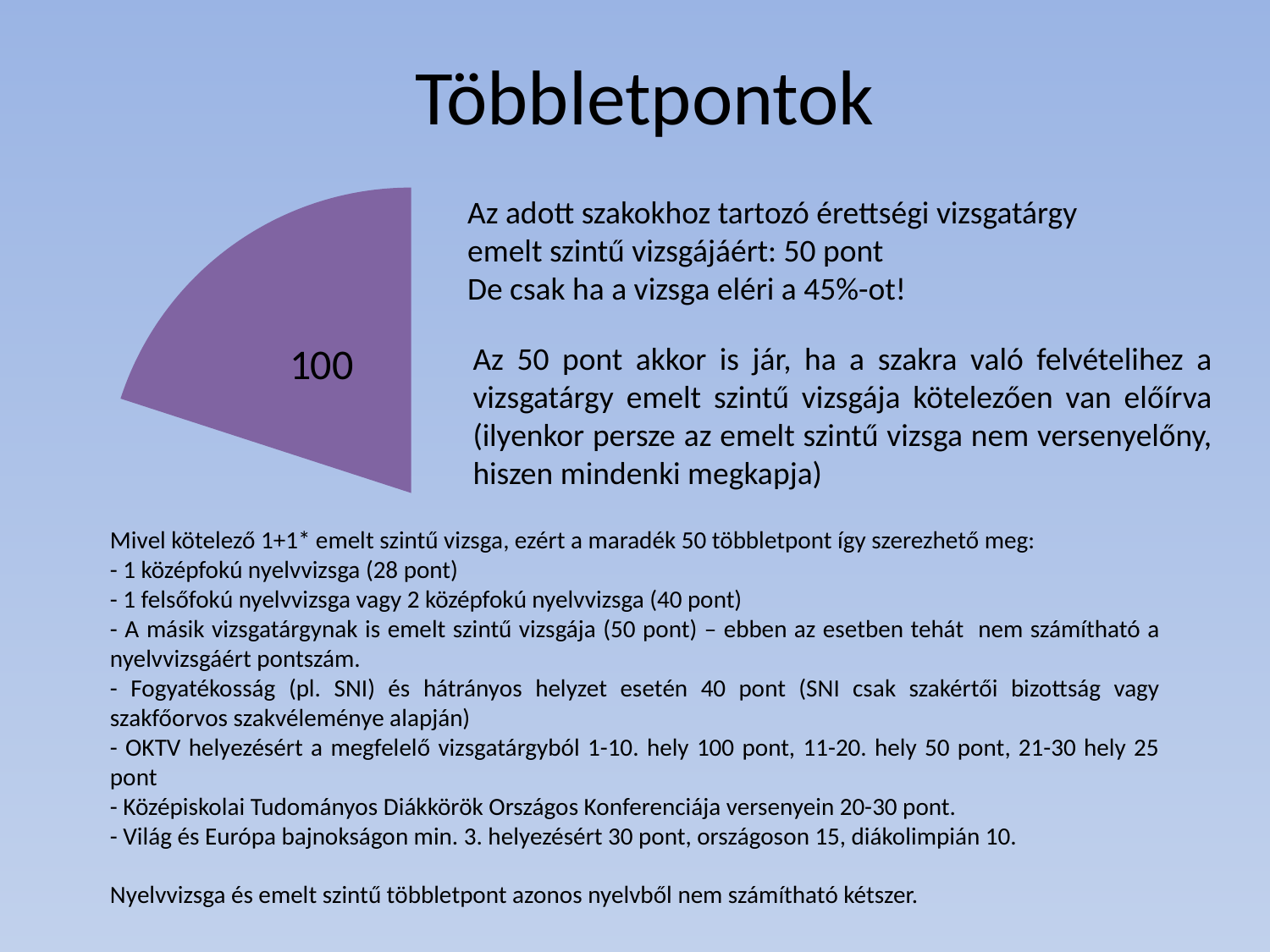
Does the pie chart show a legend? No What value is printed on the slice of the pie chart? 100 What kind of chart is shown on the left of the slide? pie chart How many slices are visible in the pie chart? 1 What colour is the slice of the pie chart? purple